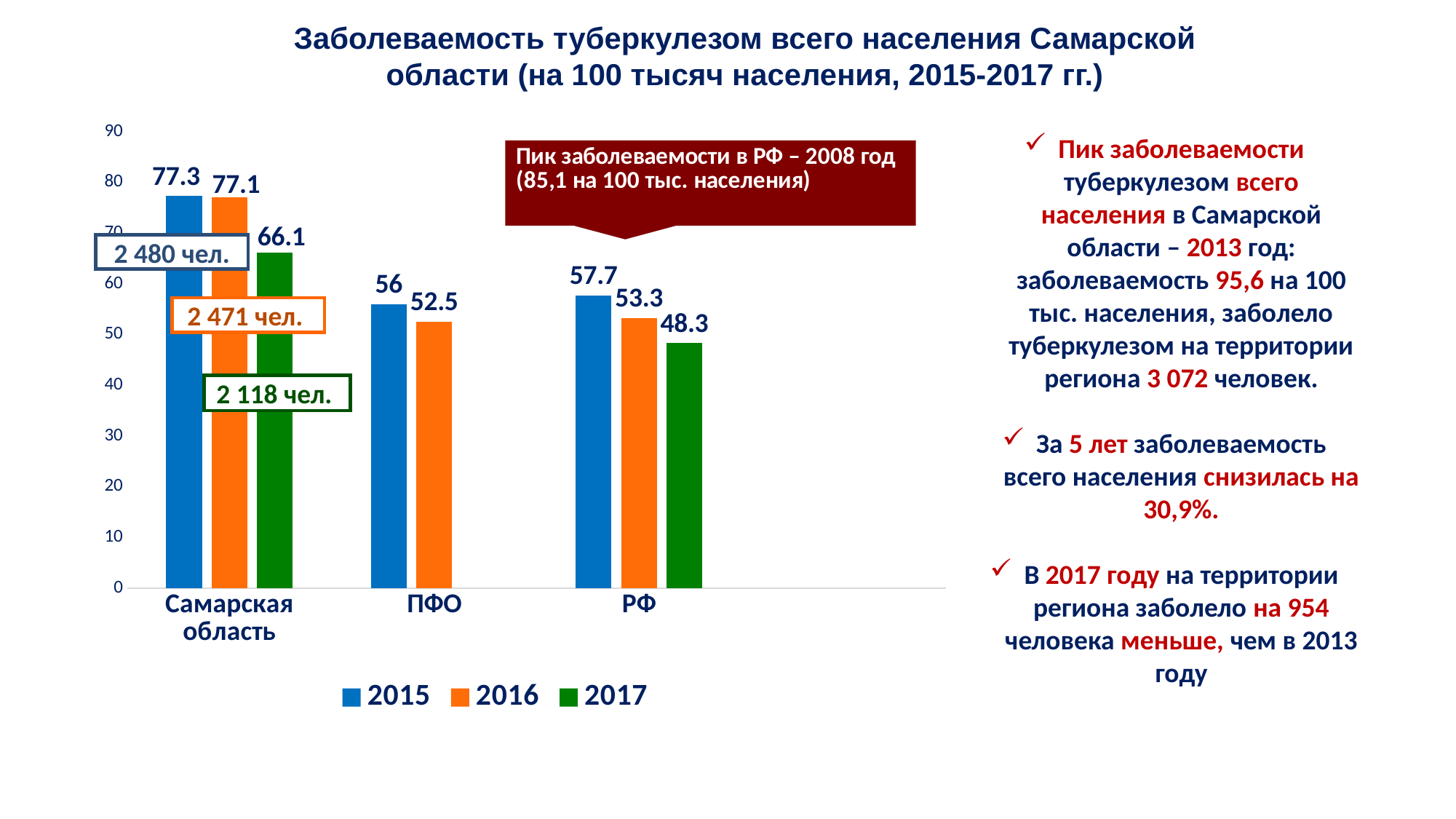
What kind of chart is shown on the slide? Bar chart What is the value for РФ in 2017? 48.3 What is the value for ПФО in 2016? 52.5 What is the value for Самарская область in 2015? 77.3 What is the difference between the 2015 and 2017 values for Самарская область? 11.2 Which category has the highest value in 2016? Самарская область What is the difference between the 2015 values for РФ and ПФО? 1.7 Is the value for Самарская область in 2017 greater or less than 60? greater Which is larger: the 2016 value for РФ or the 2016 value for ПФО? РФ How many series does the legend list? 3 Do the values for РФ rise or fall from 2015 to 2017? Fall Which category has the lowest value in 2015? ПФО